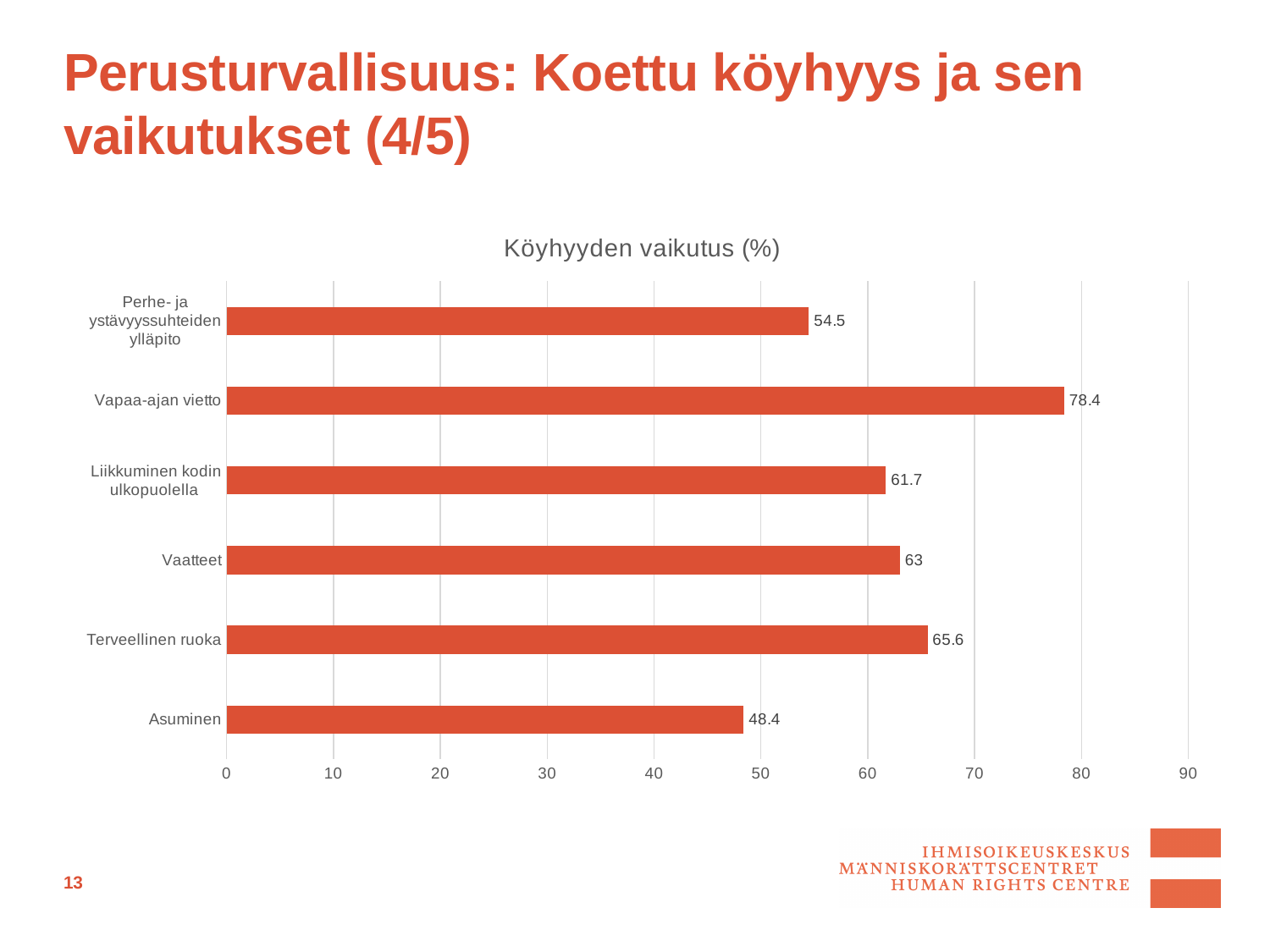
What type of chart is shown on the slide? Bar chart Which category has the lowest value? Asuminen Is the value for Liikkuminen kodin ulkopuolella greater or less than 60? greater What is the value for Vapaa-ajan vietto? 78.4 How many categories are shown in the chart? 6 Which category has the highest value? Vapaa-ajan vietto What is the difference between the values for Terveellinen ruoka and Vaatteet? 2.6 What is the difference between the values for Vapaa-ajan vietto and Asuminen? 30 Which is larger, the value for Vaatteet or the value for Perhe- ja ystävyyssuhteiden ylläpito? Vaatteet What is the value for Terveellinen ruoka? 65.6 What is the value for Asuminen? 48.4 What is the value for Liikkuminen kodin ulkopuolella? 61.7